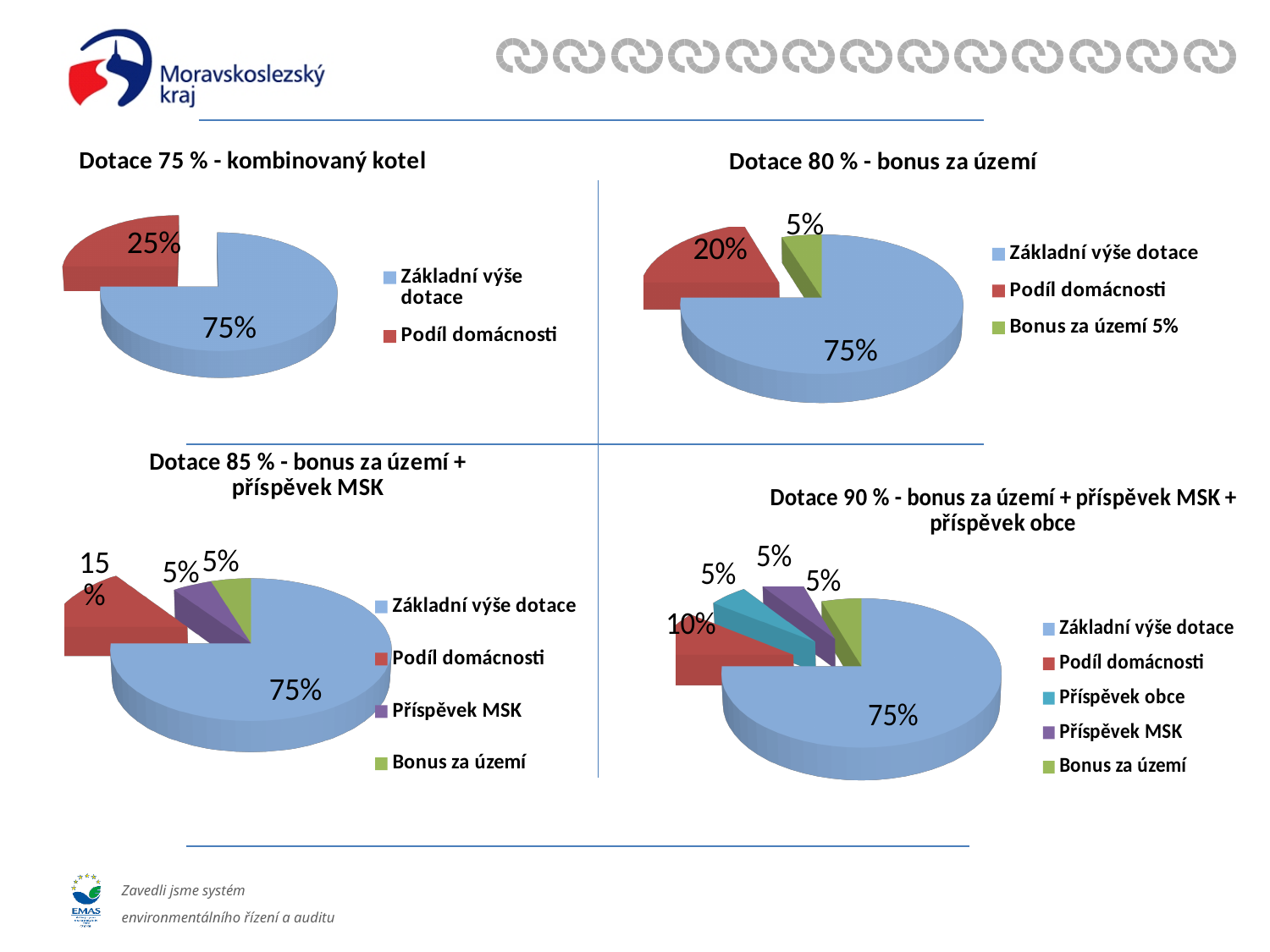
In the chart titled "Dotace 85 % - bonus za území + příspěvek MSK", what is the difference between the shares of Základní výše dotace and Podíl domácnosti? 60% In the chart titled "Dotace 80 % - bonus za území", what share does Podíl domácnosti have? 20% In the chart titled "Dotace 80 % - bonus za území", which category has the largest share? Základní výše dotace In the chart titled "Dotace 85 % - bonus za území + příspěvek MSK", what share does Podíl domácnosti have? 15% How many categories does the legend list in the chart titled "Dotace 90 % - bonus za území + příspěvek MSK + příspěvek obce"? 5 In the chart titled "Dotace 75 % - kombinovaný kotel", what share does Podíl domácnosti have? 25% How many categories does the legend list in the chart titled "Dotace 85 % - bonus za území + příspěvek MSK"? 4 What kind of chart is the chart titled "Dotace 75 % - kombinovaný kotel"? Pie chart In the chart titled "Dotace 90 % - bonus za území + příspěvek MSK + příspěvek obce", which is larger: Podíl domácnosti or Příspěvek MSK? Podíl domácnosti In the chart titled "Dotace 90 % - bonus za území + příspěvek MSK + příspěvek obce", what share does Příspěvek obce have? 5% In the chart titled "Dotace 90 % - bonus za území + příspěvek MSK + příspěvek obce", what share does Podíl domácnosti have? 10% In the chart titled "Dotace 80 % - bonus za území", what colour is the Bonus za území 5% slice? Green